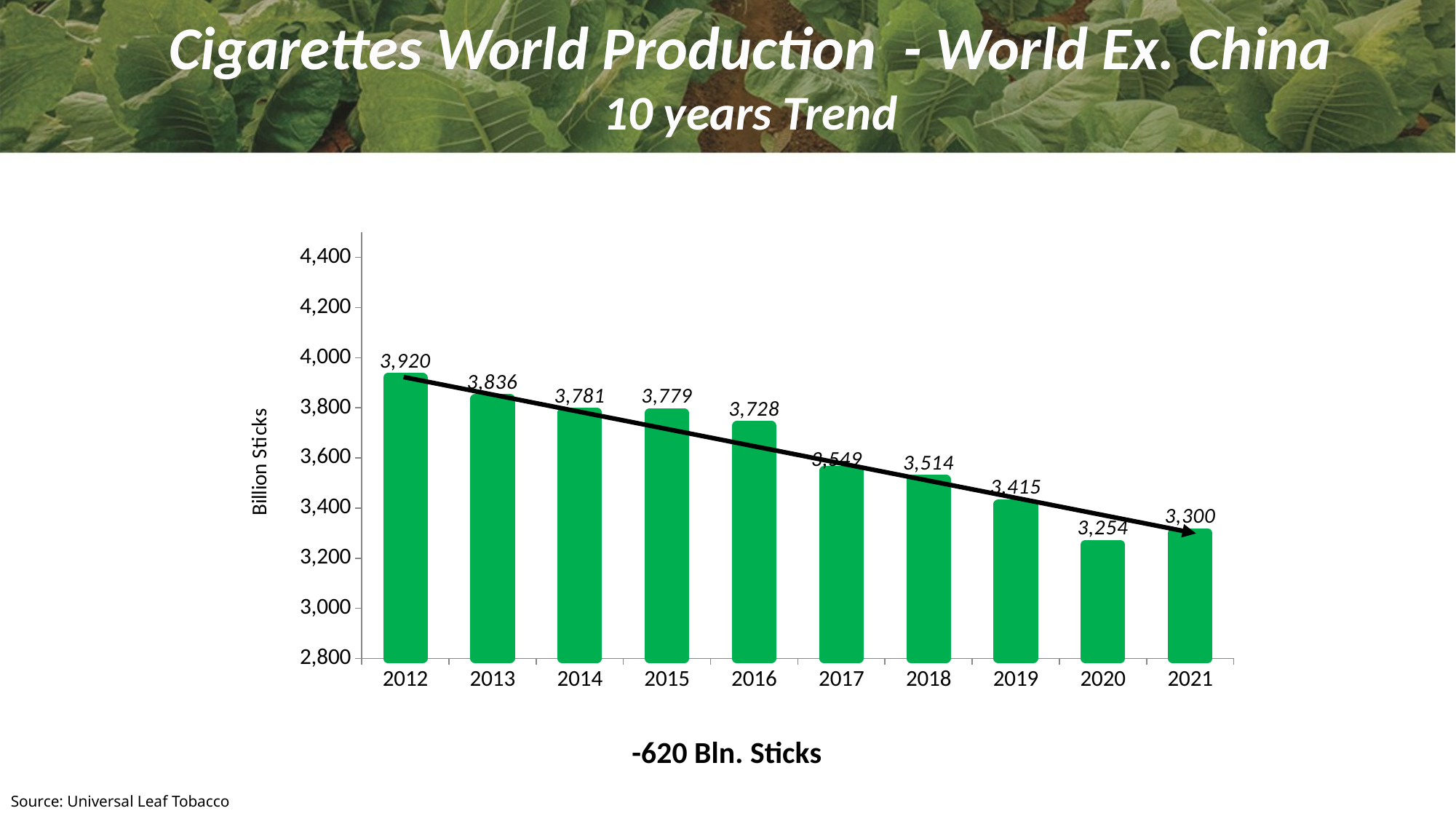
What is the difference between the 2012 and 2021 production values? 620 What kind of chart is shown on the slide? bar chart Which year had higher production, 2018 or 2021? 2018 What is the unit shown on the y axis label? Billion Sticks What is the difference between the 2019 and 2020 production values? 161 Which year has the highest production value? 2012 What was cigarette production (World Ex. China) in 2012? 3,920 What was cigarette production (World Ex. China) in 2020? 3,254 How many years are shown on the x axis? 10 Is the value for 2017 greater or less than 3,600? less What was cigarette production (World Ex. China) in 2016? 3,728 Which year has the lowest production value? 2020